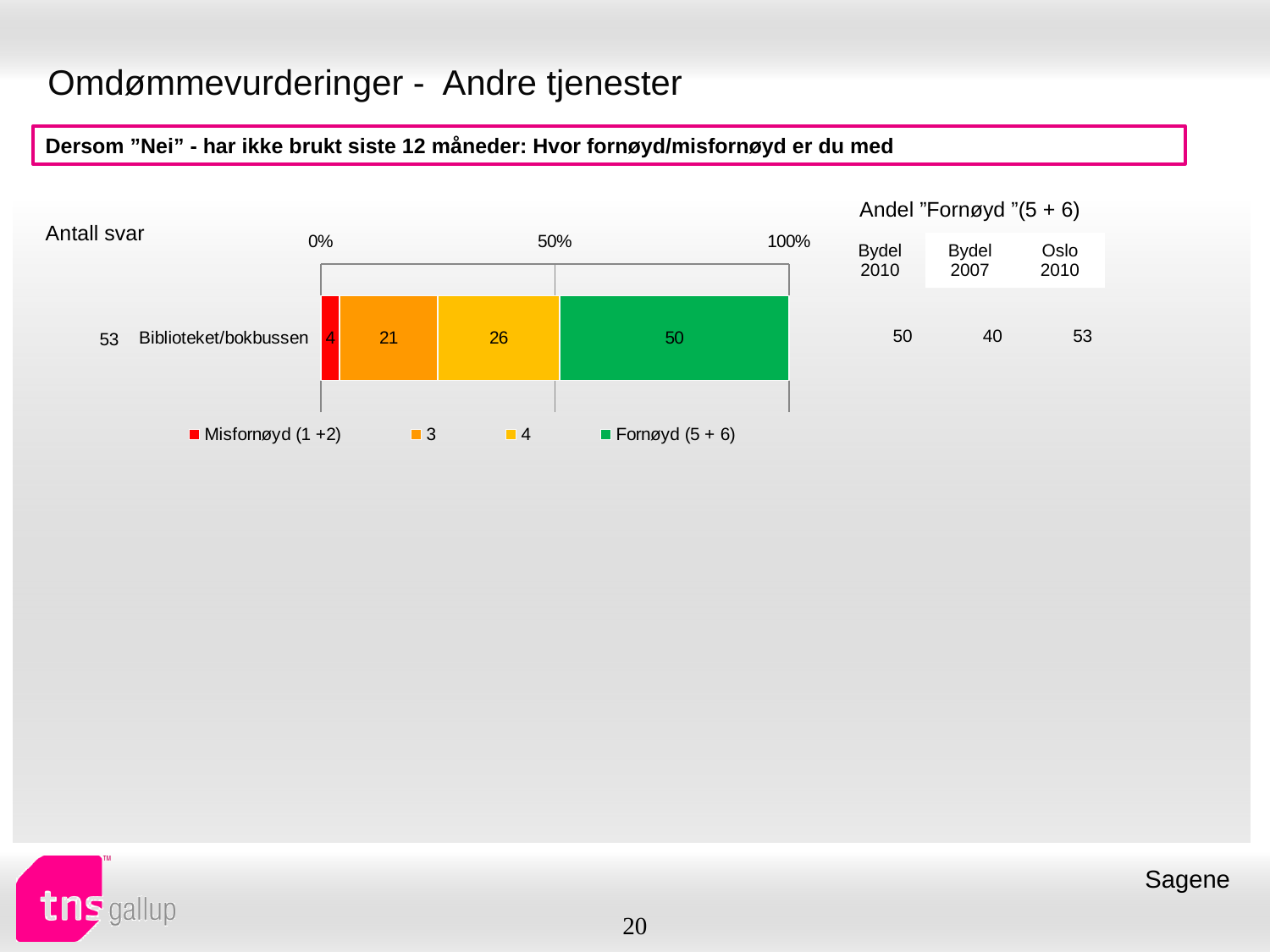
How many categories are plotted in the chart? 1 Which is larger for Biblioteket/bokbussen, the "3" segment or the "4" segment? 4 What is the difference between the "Fornøyd (5 + 6)" segment and the "4" segment for Biblioteket/bokbussen? 24 What is the value of the "Misfornøyd (1 +2)" segment for Biblioteket/bokbussen? 4 What kind of chart is shown on the slide? bar chart What is the value of the "4" segment for Biblioteket/bokbussen? 26 What is the value of the "3" segment for Biblioteket/bokbussen? 21 Which segment is the smallest for Biblioteket/bokbussen? Misfornøyd (1 +2) What is the value of the "Fornøyd (5 + 6)" segment for Biblioteket/bokbussen? 50 Which segment is the largest for Biblioteket/bokbussen? Fornøyd (5 + 6) How many series does the legend list? 4 What is the number of responses (Antall svar) shown for Biblioteket/bokbussen? 53